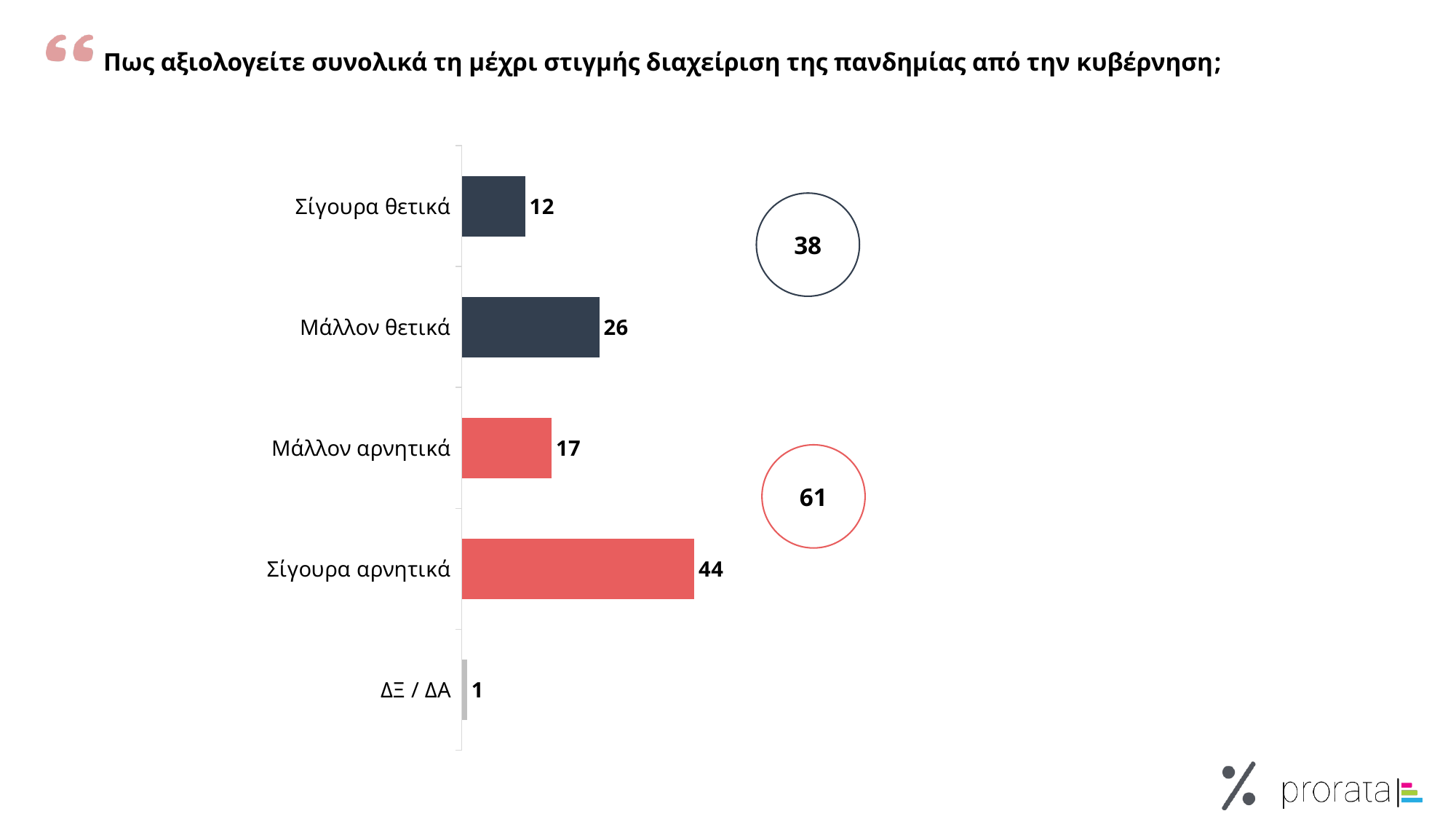
What is the value for Σίγουρα αρνητικά? 44 What kind of chart is shown on the slide? Bar chart How many categories are shown in the chart? 5 What is the value for Σίγουρα θετικά? 12 Which is larger, the value for Μάλλον θετικά or the value for Μάλλον αρνητικά? Μάλλον θετικά What is the value for Μάλλον αρνητικά? 17 Which category has the highest value? Σίγουρα αρνητικά Which category has the lowest value? ΔΞ / ΔΑ What number is shown in the circle next to the red (negative) bars? 61 What is the difference between the values for Σίγουρα αρνητικά and Μάλλον θετικά? 18 What is the value for Μάλλον θετικά? 26 What is the value for ΔΞ / ΔΑ? 1